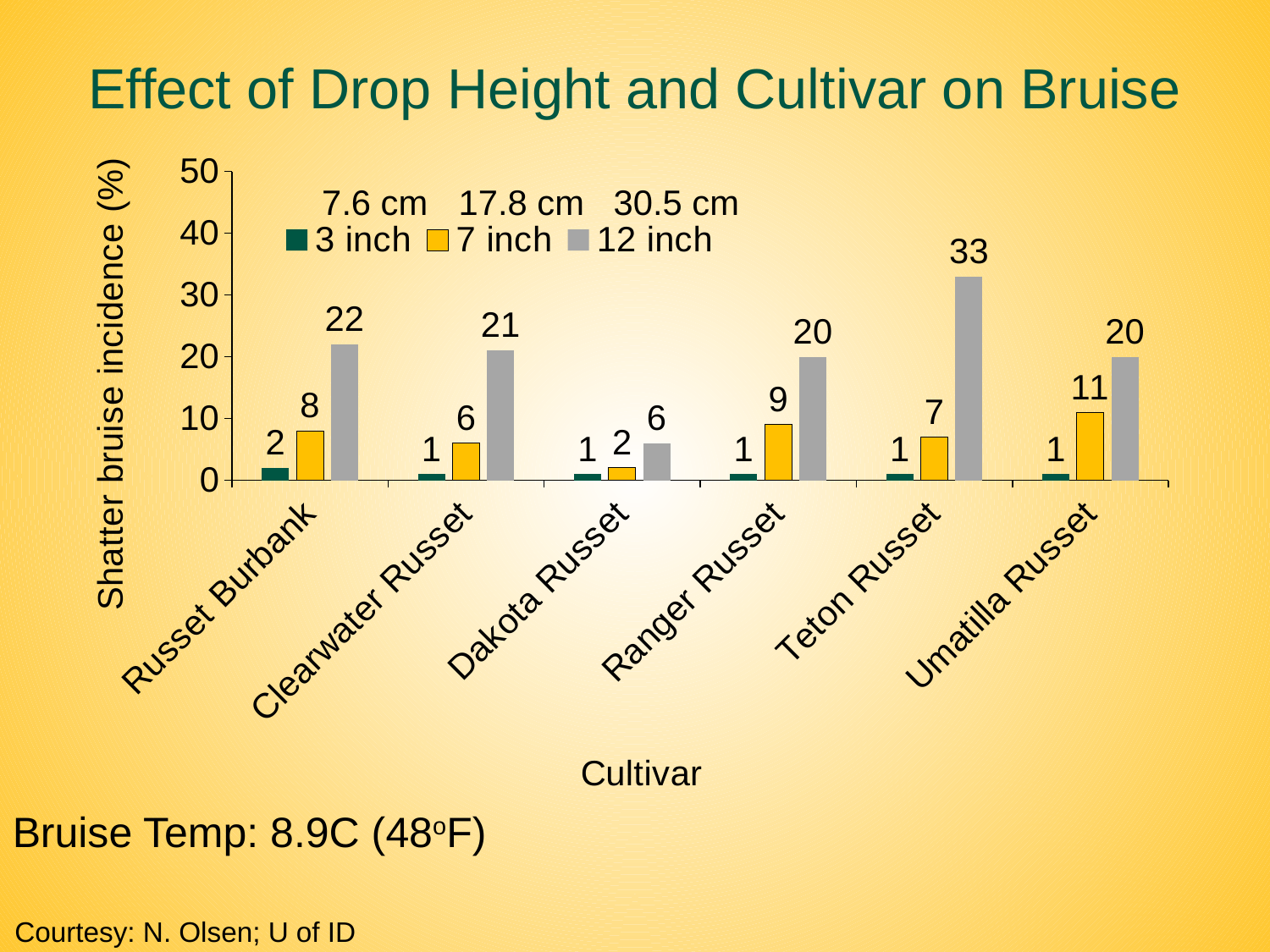
What kind of chart is shown on the slide? Bar chart What is the shatter bruise incidence for Russet Burbank at the 3 inch drop height? 2 What is the label of the y axis? Shatter bruise incidence (%) Is the 12 inch value for Teton Russet greater or less than 30? greater What is the difference between the 12 inch and 7 inch values for Ranger Russet? 11 Which cultivar has the lowest shatter bruise incidence at the 7 inch drop height? Dakota Russet How many cultivars are shown on the x axis? 6 What is the shatter bruise incidence for Umatilla Russet at the 7 inch drop height? 11 What is the shatter bruise incidence for Teton Russet at the 12 inch drop height? 33 Which is larger: the 12 inch value for Russet Burbank or the 12 inch value for Clearwater Russet? Russet Burbank Which cultivar has the highest shatter bruise incidence at the 12 inch drop height? Teton Russet How many series does the legend list? 3